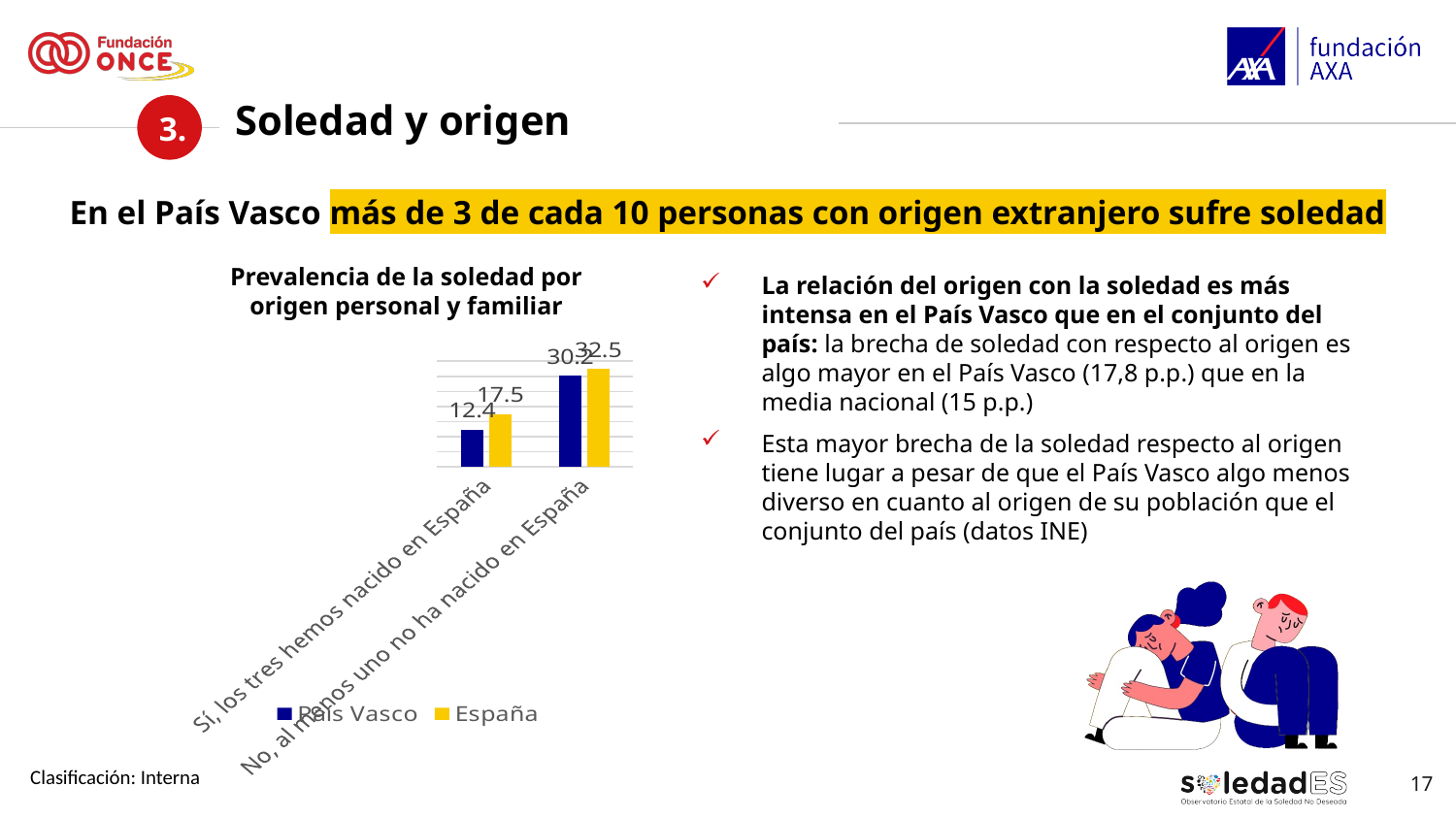
What is the title of the chart? Prevalencia de la soledad por origen personal y familiar Which category has the highest value for País Vasco? No, al menos uno no ha nacido en España What is the value for España in the category "Sí, los tres hemos nacido en España"? 17.5 How many series does the chart legend list? 2 What type of chart is shown on the slide? bar chart What is the difference between the País Vasco values for the two categories? 17.8 What is the value for País Vasco in the category "Sí, los tres hemos nacido en España"? 12.4 Which colour represents the España series in the chart? yellow Which is larger in the category "Sí, los tres hemos nacido en España": País Vasco or España? España What is the value for País Vasco in the category "No, al menos uno no ha nacido en España"? 30.2 How many categories are shown on the x axis of the chart? 2 What is the value for España in the category "No, al menos uno no ha nacido en España"? 32.5